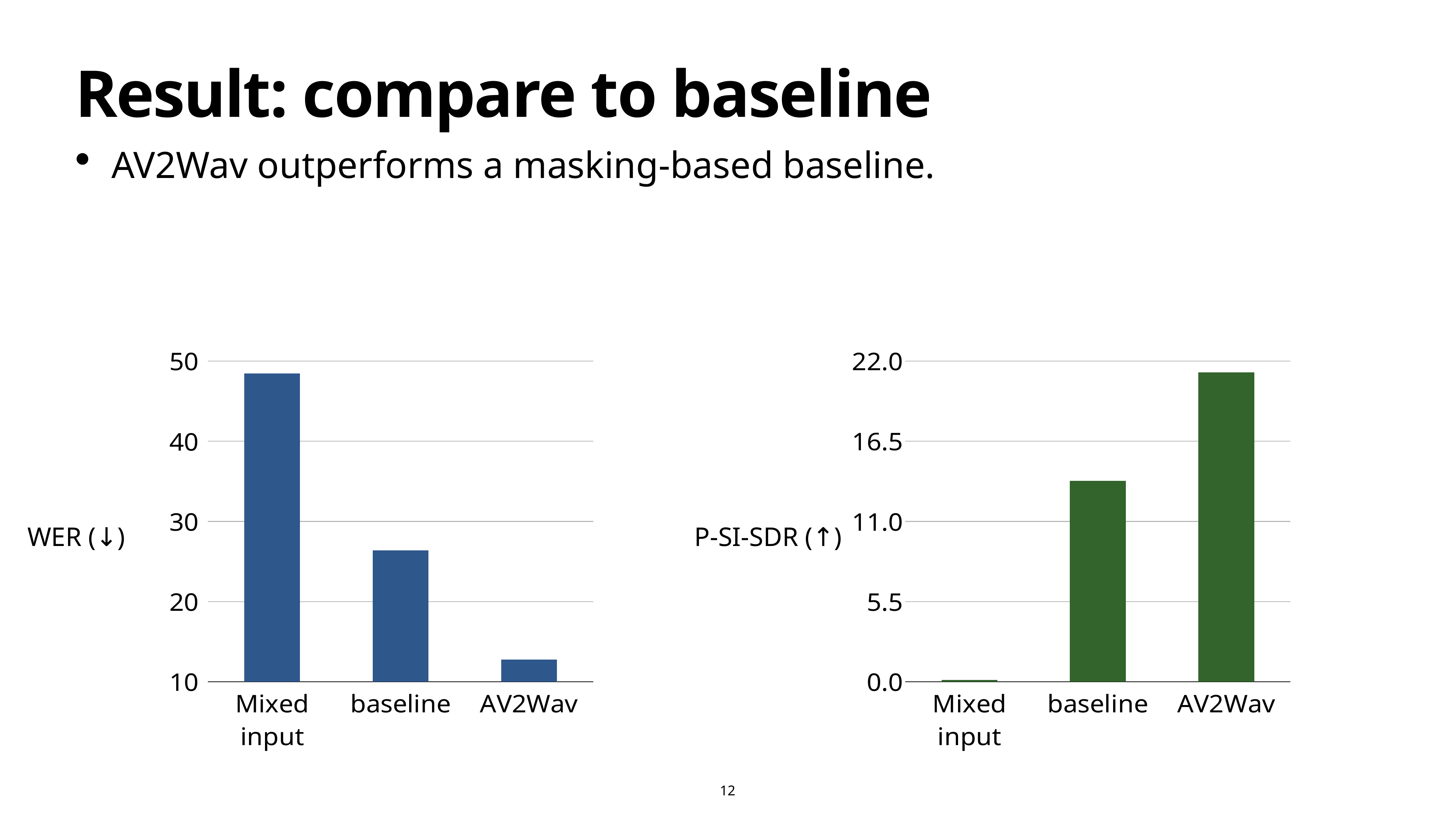
In the P-SI-SDR (↑) chart, do the values rise or fall from left to right along the x axis? rise In the WER (↓) chart, is the value for baseline greater or less than 30? less In the WER (↓) chart, which category has the lowest value? AV2Wav In the WER (↓) chart, is the value for Mixed input greater or less than 40? greater In the P-SI-SDR (↑) chart, which category has the highest value? AV2Wav In the WER (↓) chart, do the values rise or fall from left to right along the x axis? fall In the P-SI-SDR (↑) chart, is the value for baseline greater or less than 11.0? greater In the P-SI-SDR (↑) chart, which category has the lowest value? Mixed input In the P-SI-SDR (↑) chart, which is larger, the value for baseline or the value for AV2Wav? AV2Wav What kind of chart is the P-SI-SDR (↑) chart? bar chart How many categories are shown in the WER (↓) chart? 3 In the WER (↓) chart, which category has the highest value? Mixed input